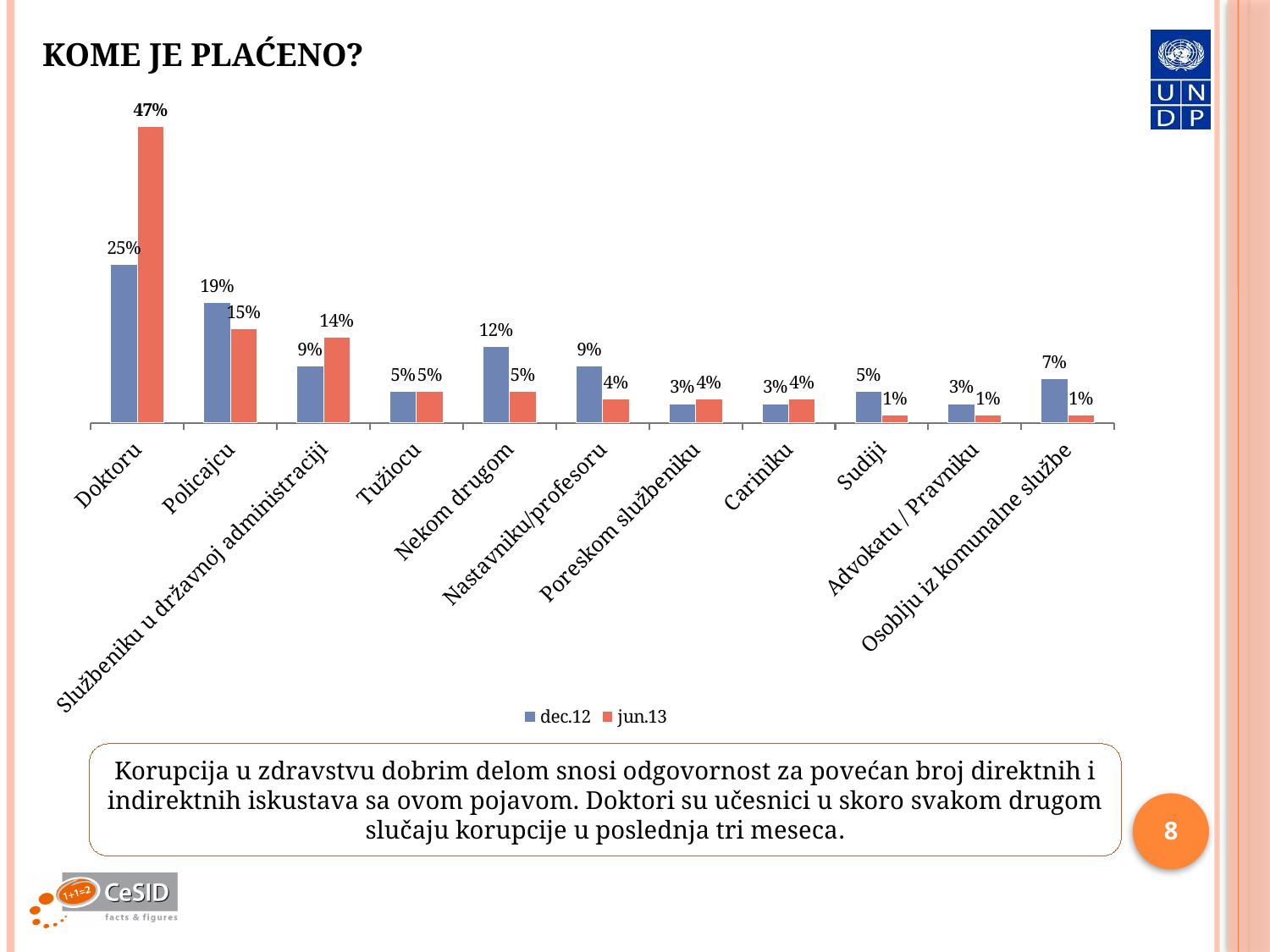
Which category has the highest jun.13 value? Doktoru What is the jun.13 value for Službeniku u državnoj administraciji? 14% Which category has the lowest dec.12 value among Poreskom službeniku, Sudiji and Osoblju iz komunalne službe? Poreskom službeniku What is the jun.13 value for Doktoru? 47% How many categories are shown on the x axis? 11 What is the dec.12 value for Policajcu? 19% What is the dec.12 value for Nekom drugom? 12% How many series does the legend list? 2 What is the title of the slide containing the chart? KOME JE PLAĆENO? What kind of chart is shown on the slide? Bar chart Which is larger for Policajcu, the dec.12 value or the jun.13 value? dec.12 What is the difference between the jun.13 and dec.12 values for Doktoru? 22%